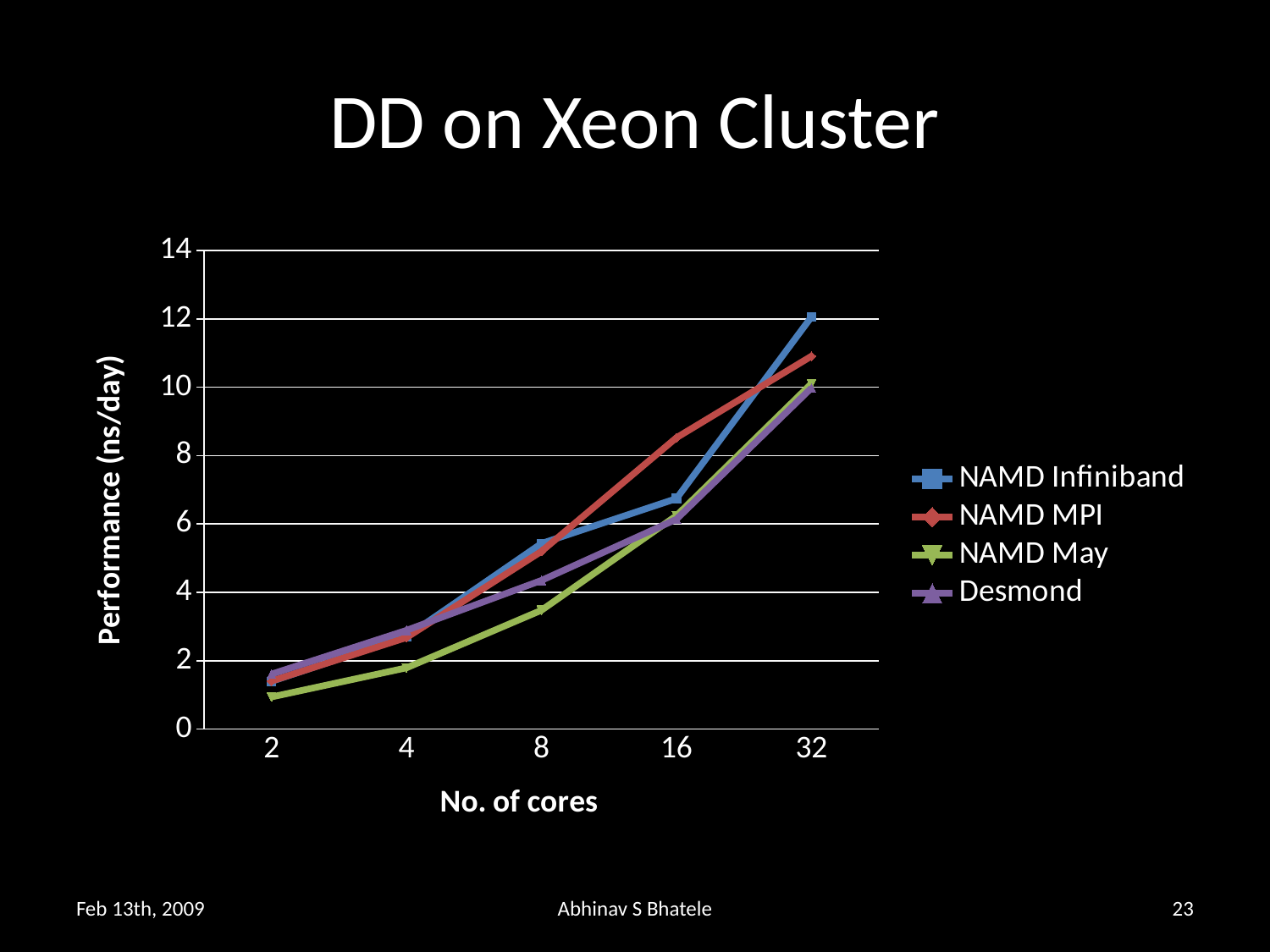
Does the performance of Desmond rise or fall as the number of cores increases? rise How many core counts are plotted along the x axis? 5 Is the value for NAMD May at 8 cores greater or less than 4? less What is the label of the y axis? Performance (ns/day) At 16 cores, which is higher: NAMD MPI or NAMD Infiniband? NAMD MPI Which series has the lowest performance at 2 cores? NAMD May How many series does the legend list? 4 Which series has the highest performance at 32 cores? NAMD Infiniband Is the value for NAMD Infiniband at 16 cores greater or less than 8? less What kind of chart is shown on the slide? line chart Which series has the lowest performance at 8 cores? NAMD May Is the value for NAMD MPI at 32 cores greater or less than 10? greater